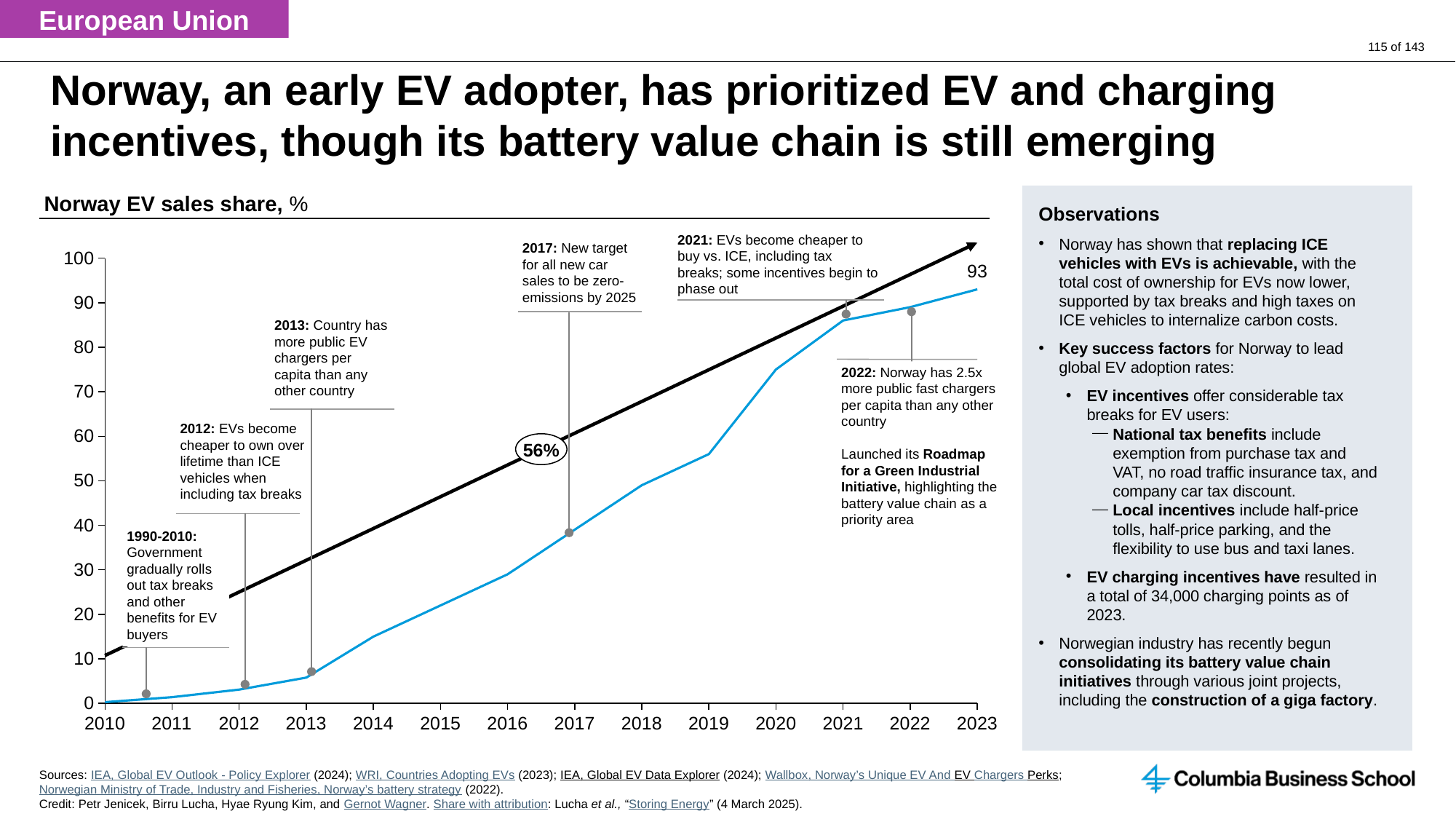
Is the EV sales share for 2020 greater or less than 70? greater Which year has a larger EV sales share, 2017 or 2020? 2020 Is the EV sales share for 2017 greater or less than 50? less What is the highest value labelled on the chart's y axis? 100 How many years are shown on the x axis of the chart? 14 Which year has the lowest EV sales share on the chart? 2010 What is the Norway EV sales share shown for 2023? 93 Is the EV sales share for 2014 greater or less than 20? less What kind of chart is used to show Norway's EV sales share? Line chart Does Norway's EV sales share rise or fall from 2010 to 2023? Rise What is the title of the chart? Norway EV sales share, % Which year has the highest EV sales share on the chart? 2023